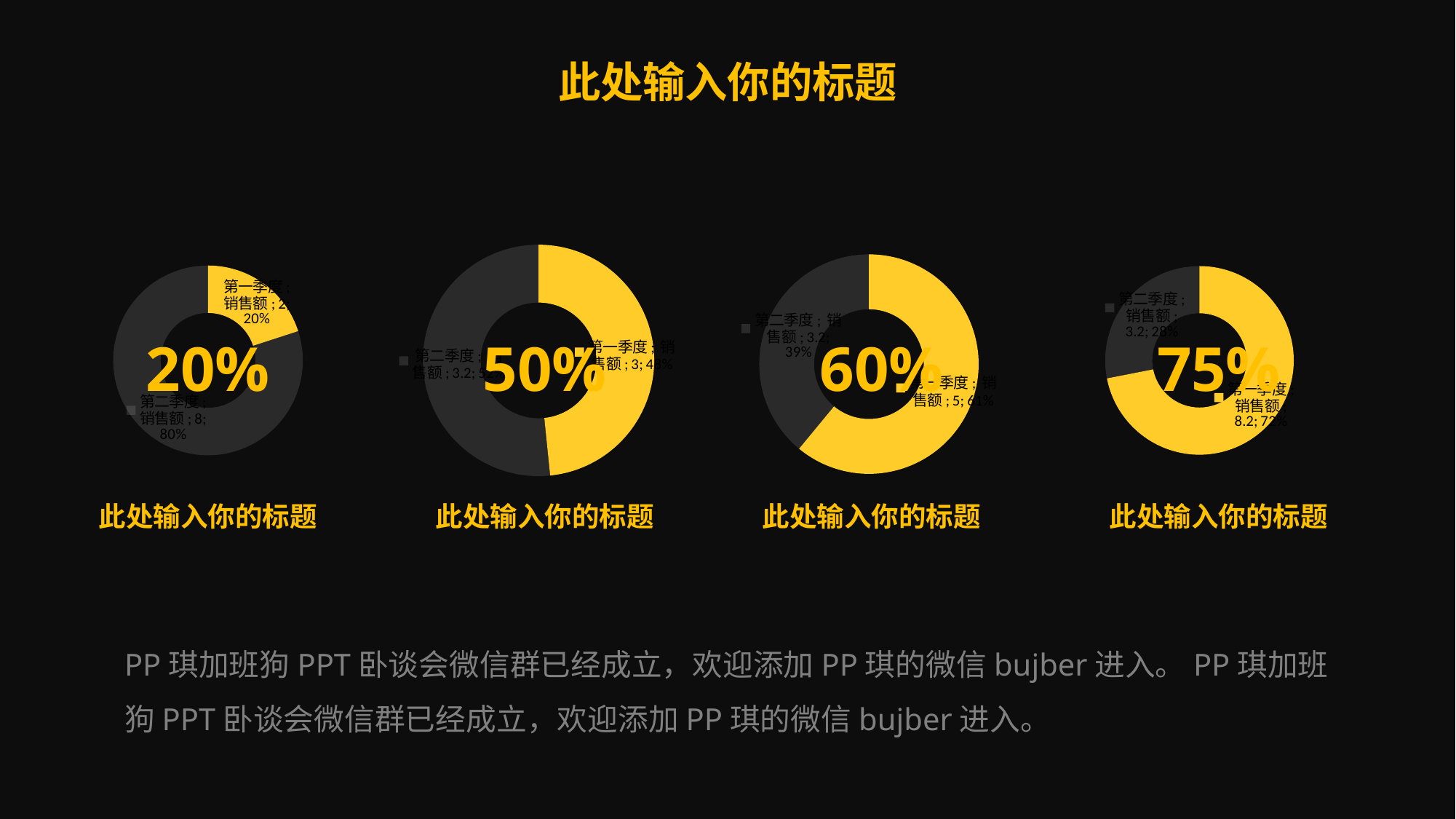
In the rightmost chart, what is the 销售额 value for 第二季度? 3.2 How many doughnut charts are shown on the slide? 4 In the leftmost chart, what share of the doughnut does 第一季度 take? 20% In the third chart from the left, which slice is larger, 第一季度 or 第二季度? 第一季度 In the third chart from the left, what is the 销售额 value for 第二季度? 3.2 What kind of chart is the leftmost chart on the slide? Doughnut chart In the third chart from the left, what share of the doughnut does 第二季度 take? 39% In the leftmost chart, what share of the doughnut does 第二季度 take? 80% In the leftmost chart, what is the 销售额 value for 第二季度? 8 How many slices does the rightmost doughnut chart have? 2 In the leftmost chart, which slice is larger, 第一季度 or 第二季度? 第二季度